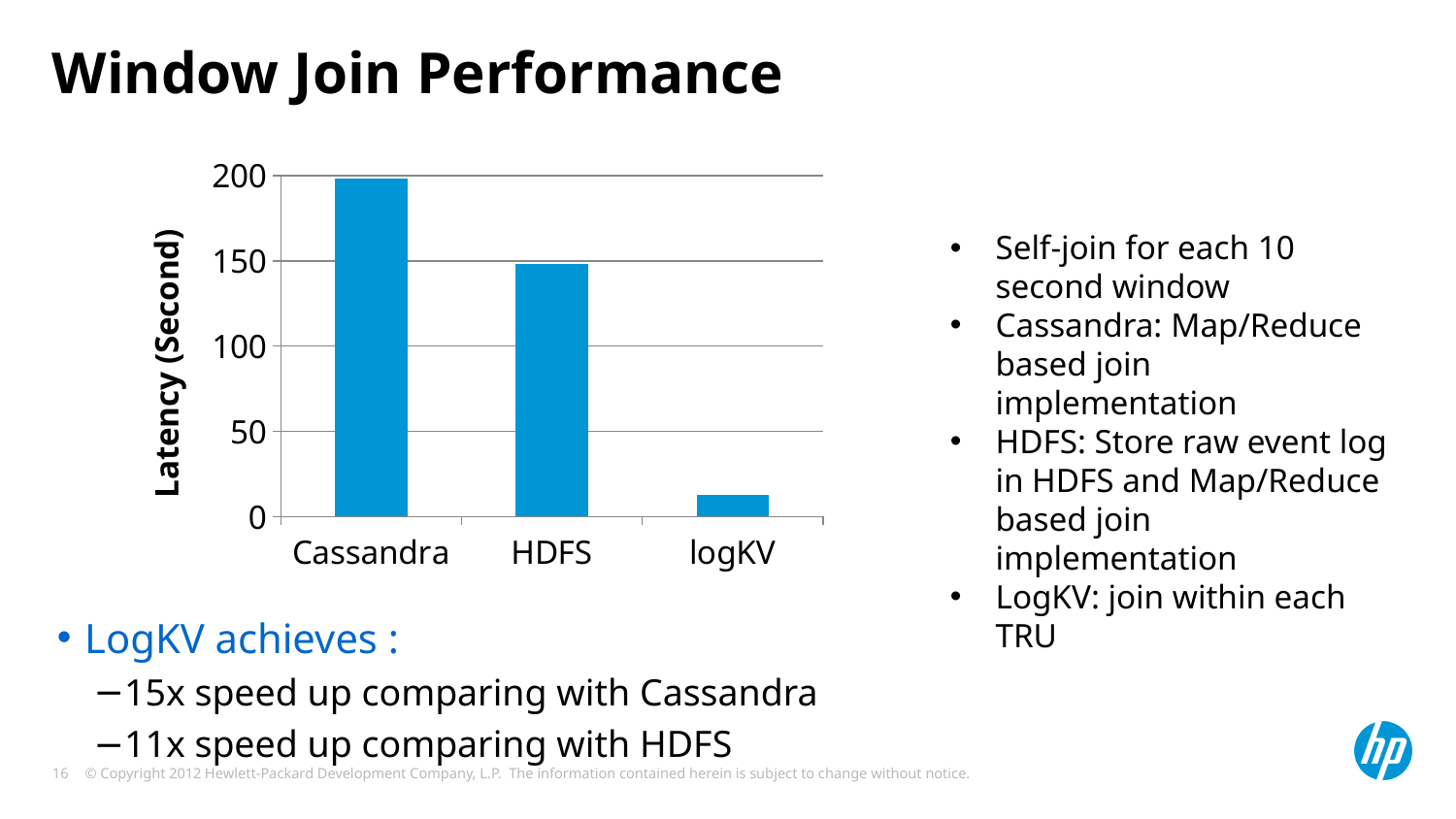
Is the latency for HDFS greater or less than 100? greater Is the latency for logKV greater or less than 50? less Is the latency for HDFS greater or less than 200? less Which category has the lowest latency in the chart? logKV Which has a higher latency, Cassandra or HDFS? Cassandra What kind of chart is shown on the slide? bar chart How many categories are plotted on the x axis of the chart? 3 Do the bar values rise or fall moving from Cassandra to logKV along the x axis? fall Which has a higher latency, HDFS or logKV? HDFS What is the label of the vertical axis of the chart? Latency (Second) Which category has the highest latency in the chart? Cassandra